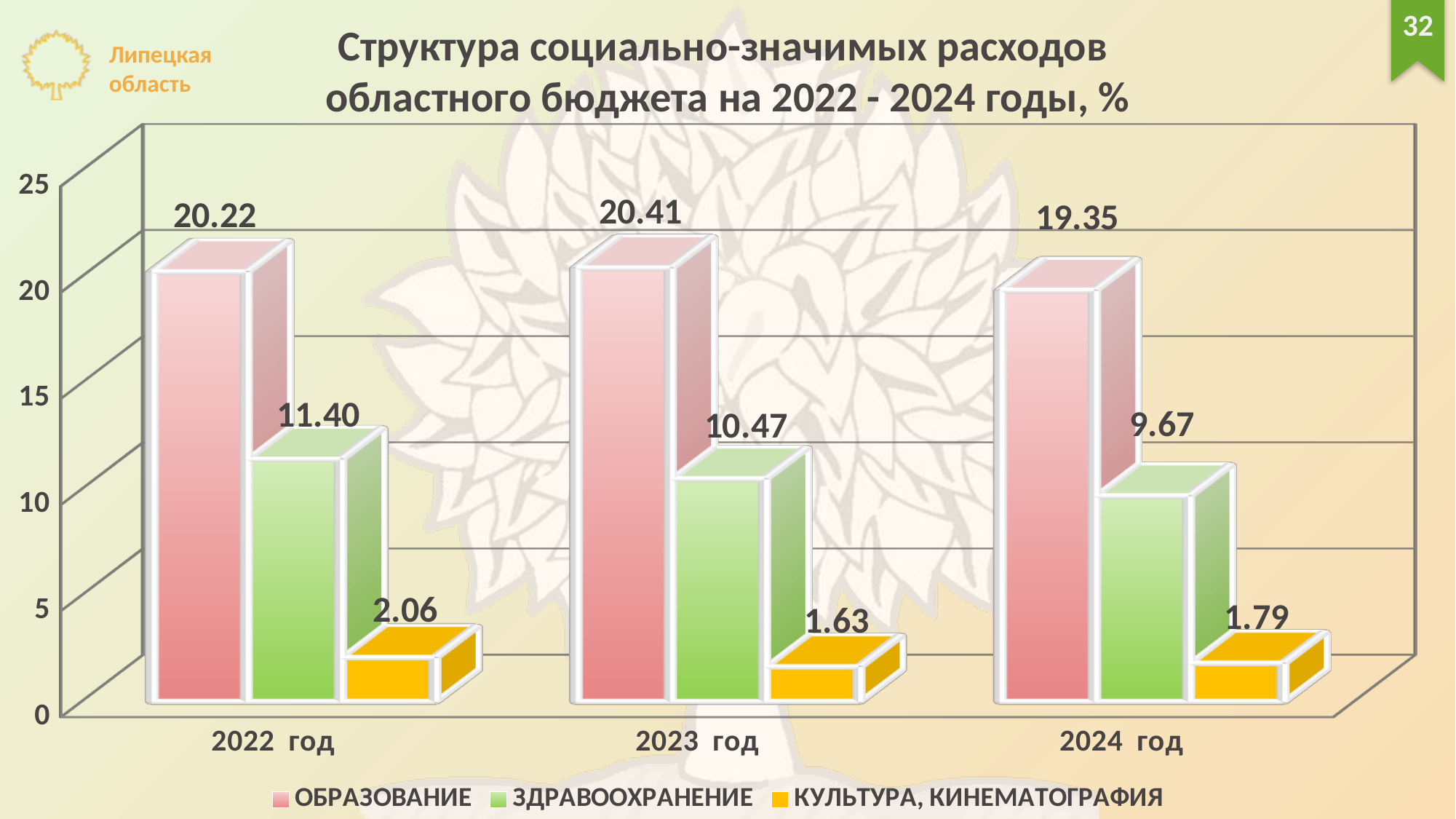
What is the value for КУЛЬТУРА, КИНЕМАТОГРАФИЯ in 2024 год? 1.79 How many years are shown on the x axis? 3 In which year is the КУЛЬТУРА, КИНЕМАТОГРАФИЯ value lowest? 2023 год What kind of chart is shown on the slide? bar chart What is the difference between the ОБРАЗОВАНИЕ and ЗДРАВООХРАНЕНИЕ values in 2022 год? 8.82 Is the ЗДРАВООХРАНЕНИЕ value for 2024 год greater or less than 10? less Which is larger: the ЗДРАВООХРАНЕНИЕ value in 2022 год or in 2024 год? 2022 год How many series does the legend list? 3 What is the value for ОБРАЗОВАНИЕ in 2022 год? 20.22 What is the value for ЗДРАВООХРАНЕНИЕ in 2023 год? 10.47 What is the difference between the ЗДРАВООХРАНЕНИЕ values for 2022 год and 2024 год? 1.73 In which year is the ОБРАЗОВАНИЕ value highest? 2023 год